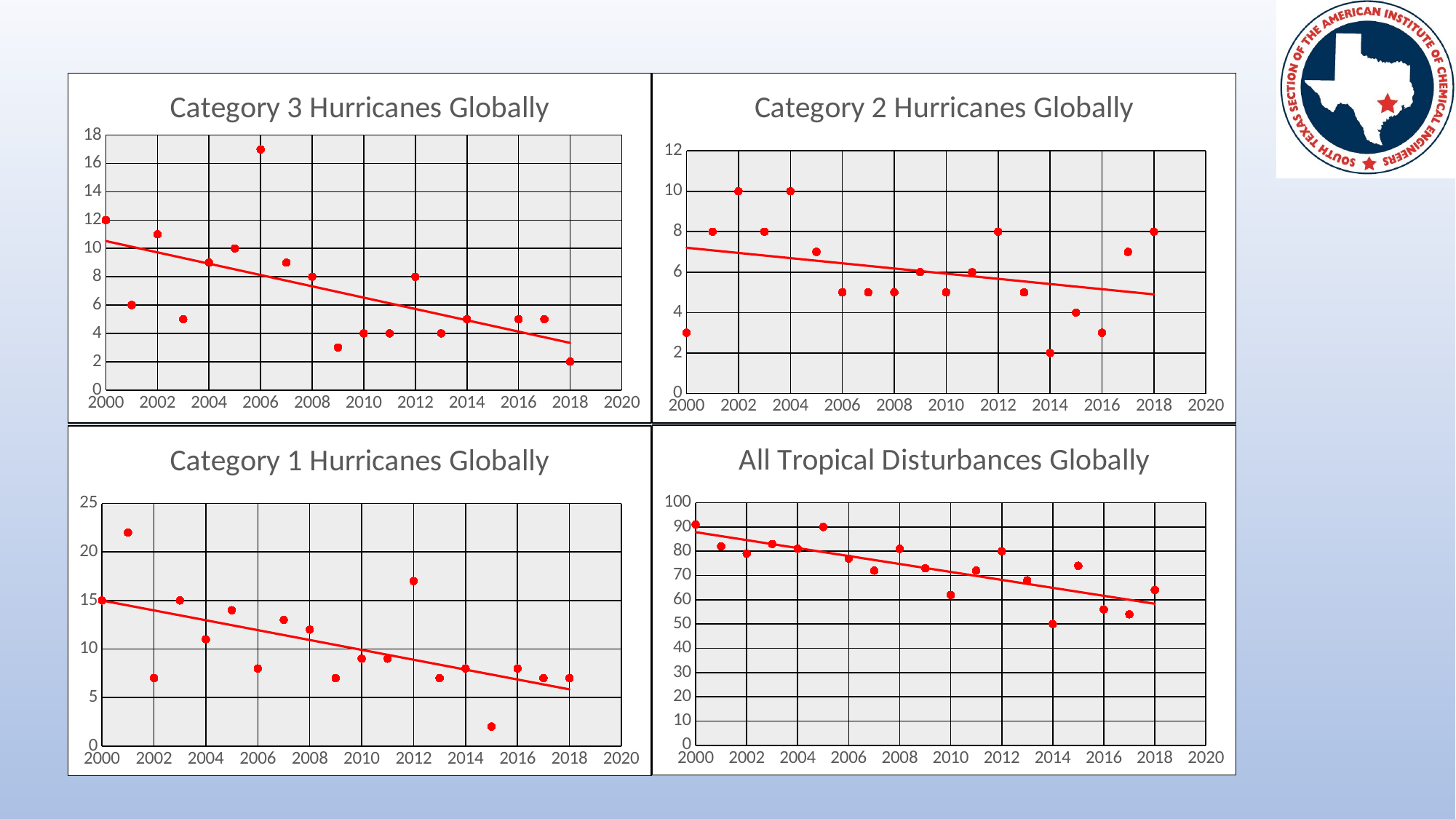
In the 'Category 1 Hurricanes Globally' chart, which year has the highest value? 2001 In the 'Category 2 Hurricanes Globally' chart, which year has the lowest value? 2014 In the 'Category 3 Hurricanes Globally' chart, which year has the lowest value? 2018 In the 'All Tropical Disturbances Globally' chart, which year has the lowest value? 2014 In the 'Category 3 Hurricanes Globally' chart, is the value for 2006 greater or less than 16? greater What kind of chart is the 'Category 3 Hurricanes Globally' chart? scatter chart How many charts are shown on the slide? 4 In the 'Category 1 Hurricanes Globally' chart, is the value for 2012 greater or less than 15? greater In the 'All Tropical Disturbances Globally' chart, do the values generally rise or fall from 2000 to 2018 according to the trend line? fall In the 'Category 2 Hurricanes Globally' chart, what is the value for 2002? 10 In the 'Category 3 Hurricanes Globally' chart, which year has the highest value? 2006 In the 'Category 3 Hurricanes Globally' chart, what is the value for 2000? 12